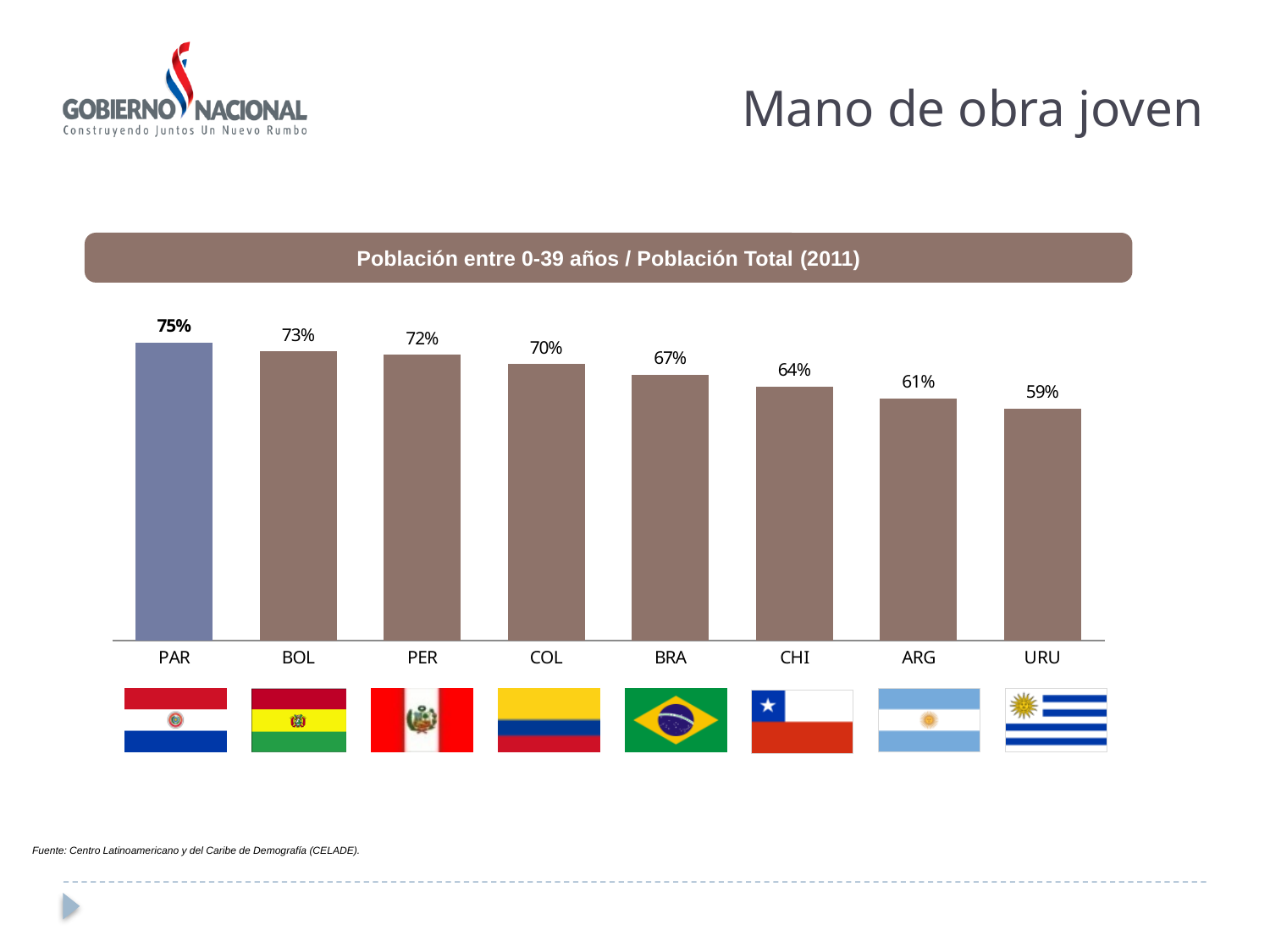
Which country has the highest value? PAR What kind of chart is shown on the slide? Bar chart What is the difference between the values for BOL and CHI? 9% What is the difference between the values for PAR and URU? 16% What is the value for ARG? 61% What is the title of the chart? Población entre 0-39 años / Población Total (2011) Which country has the lowest value? URU What is the value for PAR? 75% What is the value for BRA? 67% How many countries are shown in the chart? 8 Do the values rise or fall from left to right along the x axis? Fall Which is larger, the value for PER or the value for COL? PER